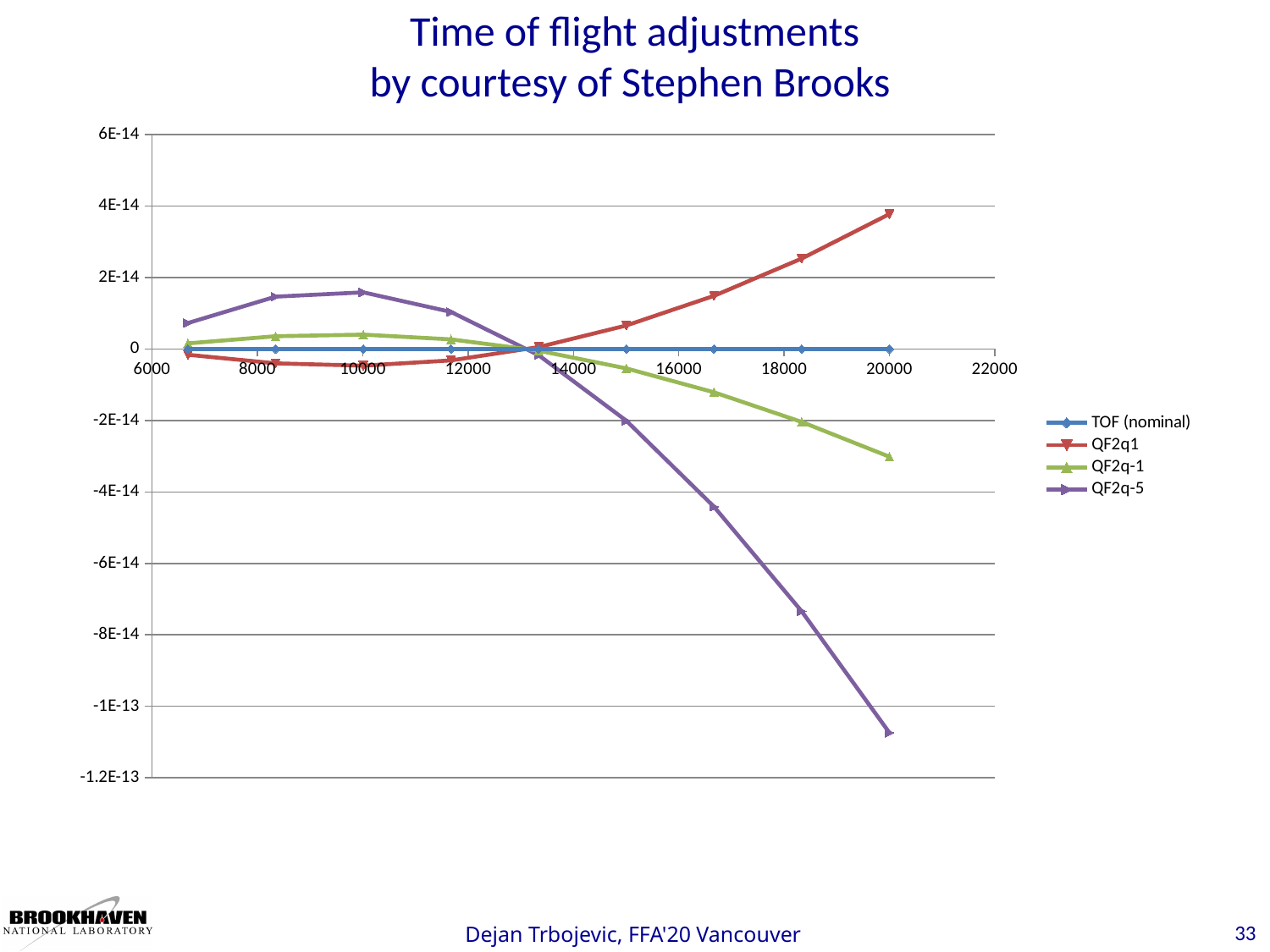
Which series has the lowest value at x = 20000? QF2q-5 What kind of chart is shown on the slide? line chart Does the QF2q-5 series rise or fall between x = 14000 and x = 20000? fall How many series does the legend list? 4 Which series has the highest value at x = 20000? QF2q1 What is the title of the chart? Time of flight adjustments by courtesy of Stephen Brooks Is the value of QF2q1 at x = 20000 greater or less than 2E-14? greater What value does the TOF (nominal) series hold across the whole x axis? 0 At x = 20000, which is larger: QF2q1 or QF2q-1? QF2q1 Is the value of QF2q-1 at x = 20000 greater or less than -2E-14? less How many data points are plotted for the QF2q-5 series? 9 Is the value of QF2q-5 at x = 20000 greater or less than -1E-13? less